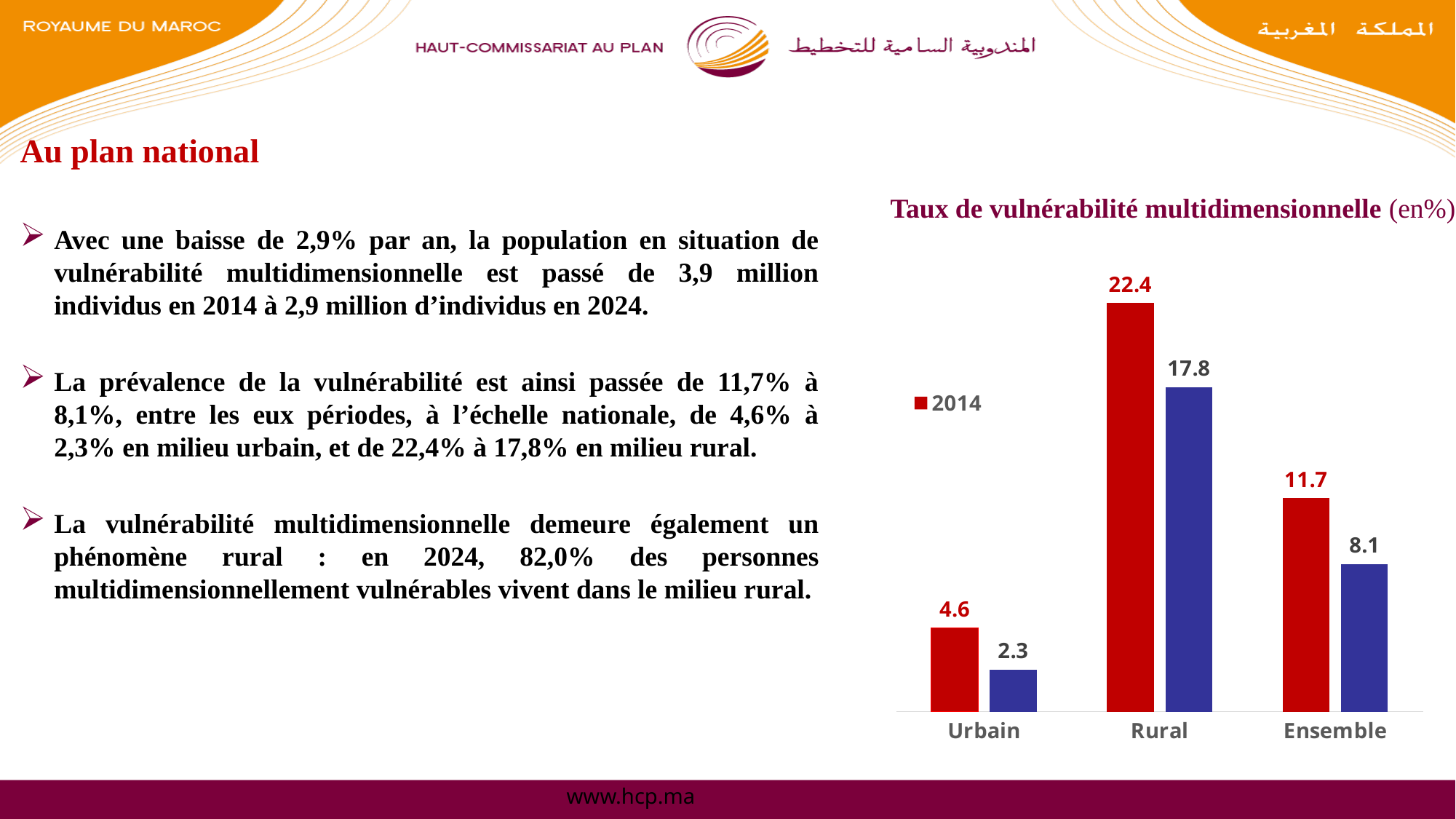
What colour are the bars for the 2014 series? Red Which category has the highest 2014 value? Rural What kind of chart is shown on the slide? Bar chart Which category has the lowest value among the blue bars? Urbain What value does the blue bar show for Rural? 17.8 What is the difference between the 2014 value and the blue bar value for Urbain? 2.3 What is the difference between the 2014 value and the blue bar value for Rural? 4.6 Which is larger: the 2014 value for Ensemble or the blue bar value for Rural? The blue bar value for Rural What value does the blue bar show for Ensemble? 8.1 What is the 2014 value for Urbain in the chart? 4.6 What is the 2014 value for Rural in the chart? 22.4 How many categories are shown on the x axis of the chart? 3